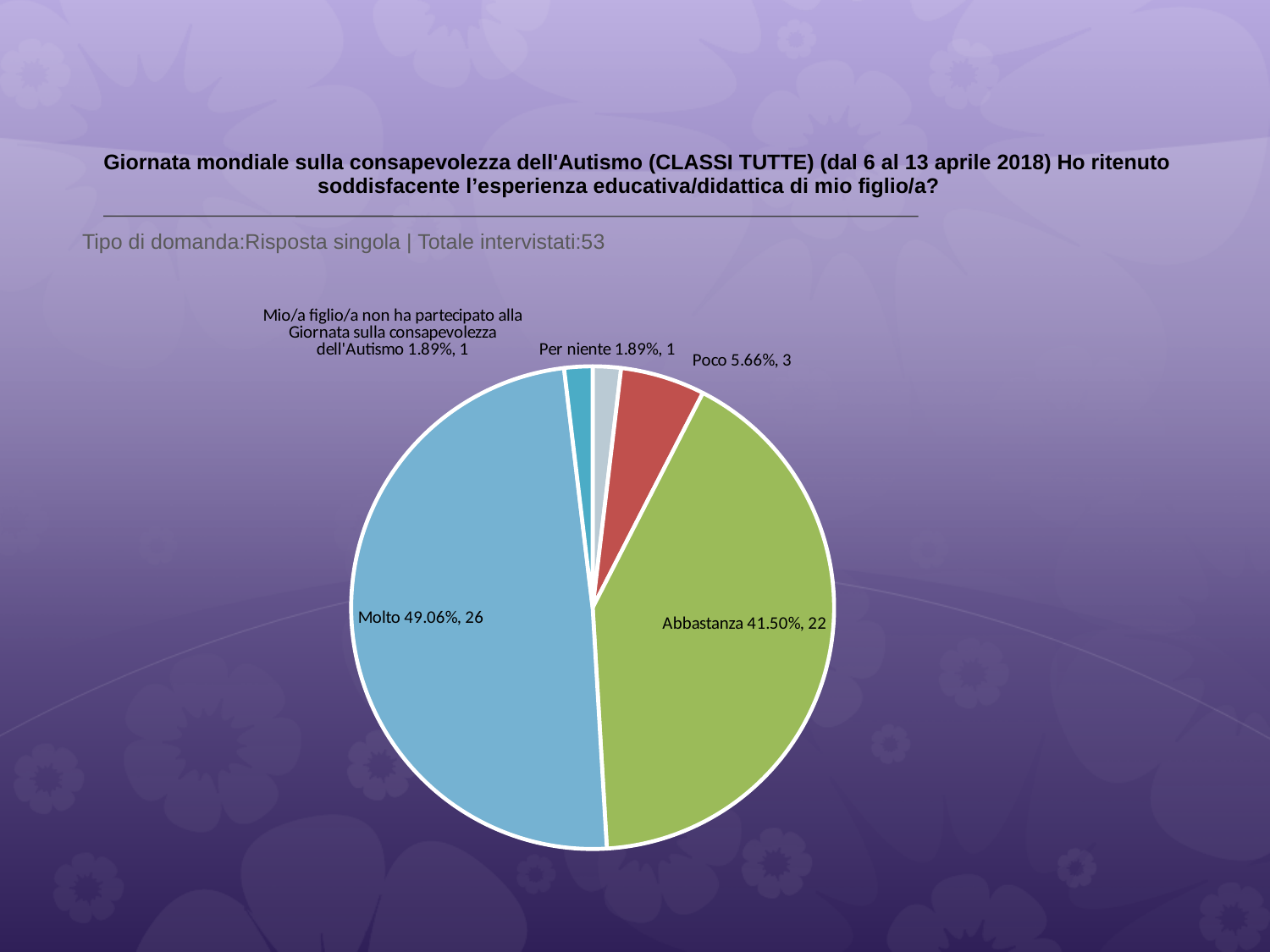
What is the total number of respondents (Totale intervistati) stated on the slide? 53 How many respondents answered 'Abbastanza'? 22 What is the difference in number of respondents between 'Poco' and 'Per niente'? 2 What percentage share does the 'Molto' slice have? 49.06% What is the difference in number of respondents between 'Molto' and 'Abbastanza'? 4 Which is larger, the 'Abbastanza' slice or the 'Poco' slice? Abbastanza Which category has the largest slice of the pie? Molto What percentage share does the slice 'Mio/a figlio/a non ha partecipato alla Giornata sulla consapevolezza dell'Autismo' have? 1.89% How many respondents answered 'Per niente'? 1 What kind of chart is shown on the slide? pie chart How many slices does the pie chart have? 5 What percentage share does the 'Poco' slice have? 5.66%